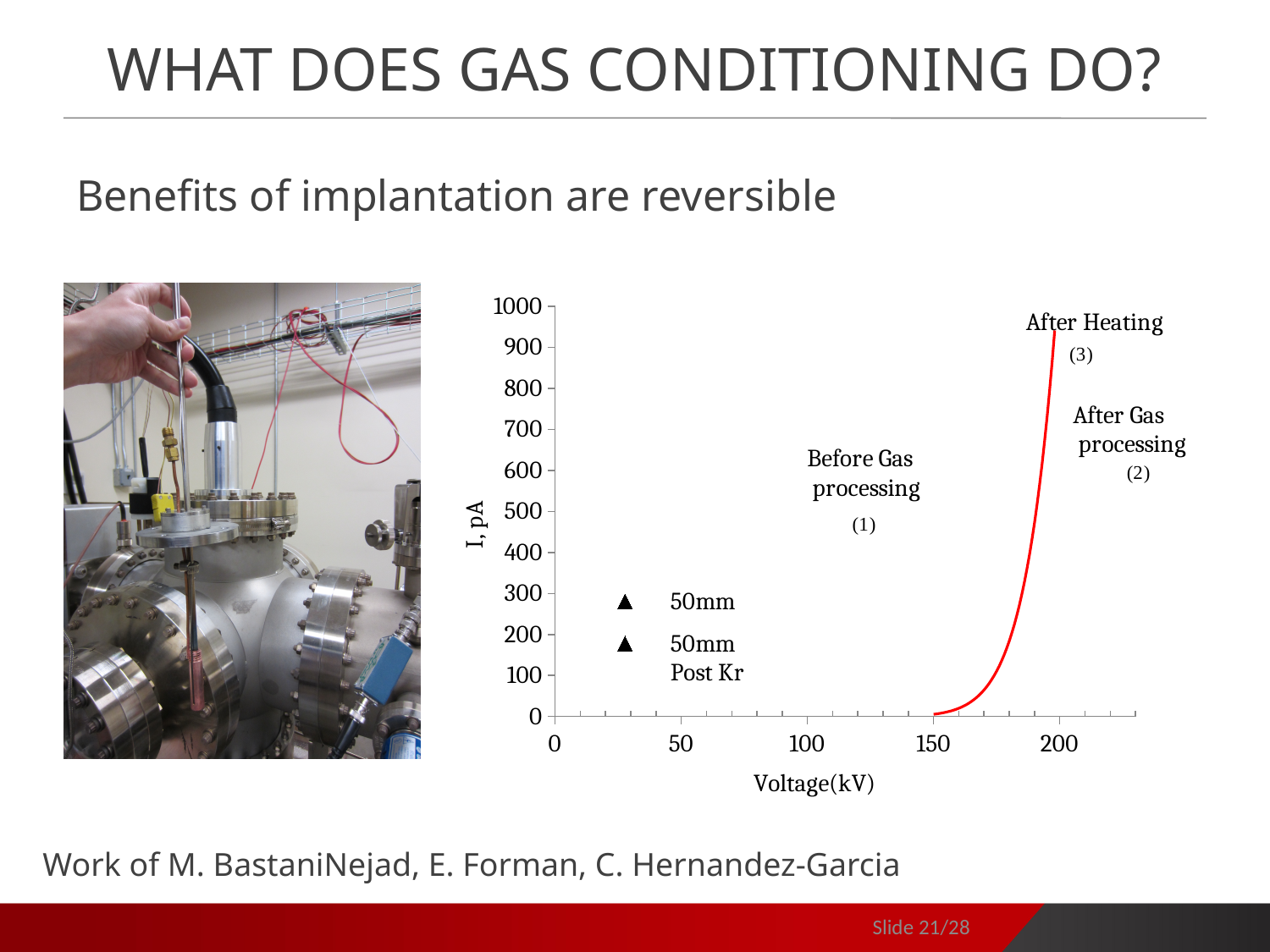
Is the maximum current reached by the red curve greater or less than 800 pA? greater How many entries does the chart's legend list? 2 What is the label of the x axis of the chart? Voltage(kV) What is the highest tick value labelled on the x axis of the chart? 200 Is the current on the red curve at 175 kV greater or less than 500 pA? less Which annotation on the chart is labelled (3)? After Heating How many numbered processing stages are annotated on the chart? 3 Is the current on the red curve at 160 kV greater or less than 100 pA? less What is the label of the y axis of the chart? I, pA What type of chart is shown on the slide? Line chart What is the highest tick value shown on the y axis of the chart? 1000 Does the current rise or fall as voltage increases along the red curve? Rises